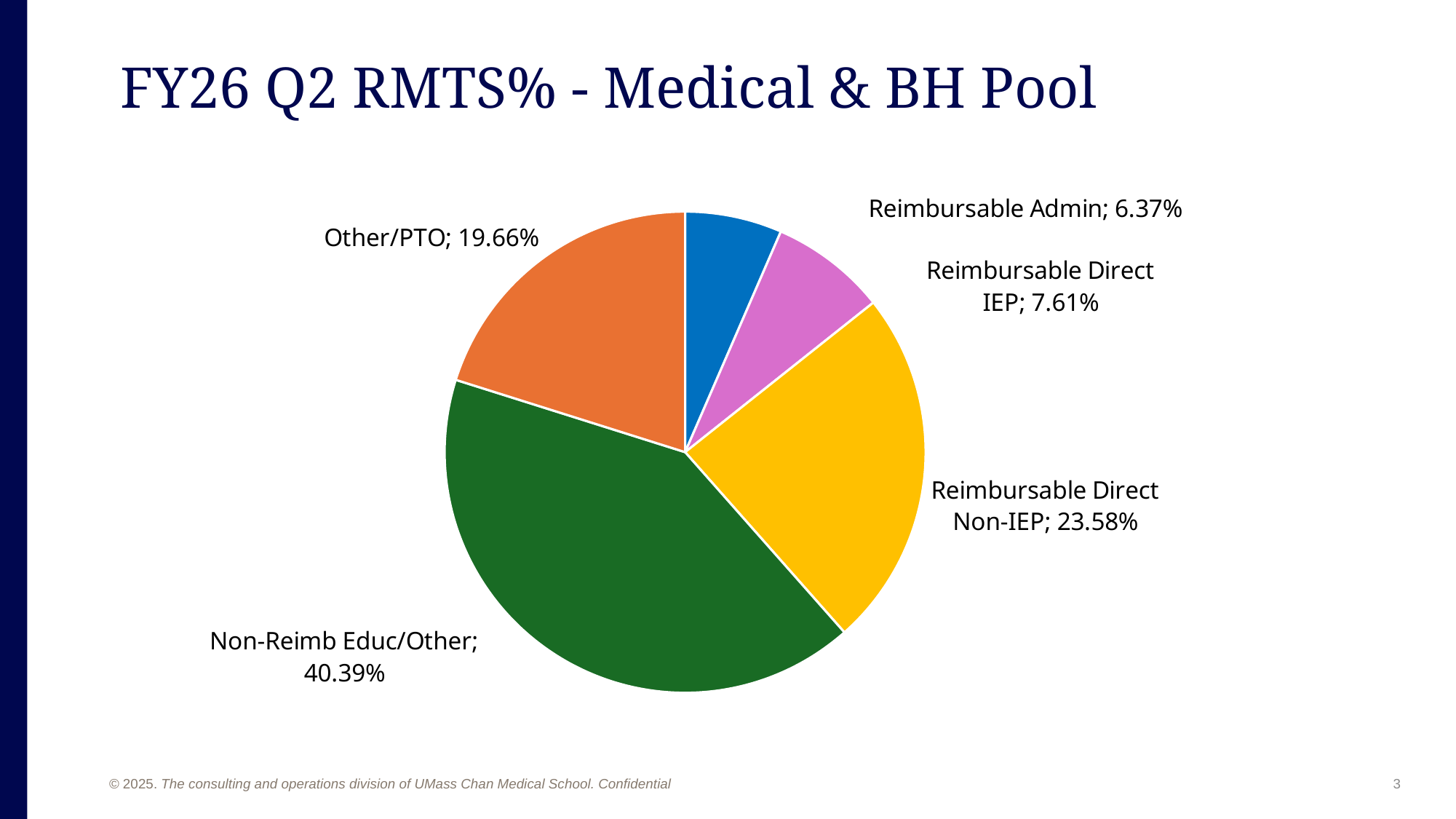
What percentage is shown for Reimbursable Admin? 6.37% How many slices does the pie chart have? 5 What is the title of the chart on the slide? FY26 Q2 RMTS% - Medical & BH Pool What percentage is shown for Reimbursable Direct Non-IEP? 23.58% What colour is the Non-Reimb Educ/Other slice? Green What is the difference between the Non-Reimb Educ/Other share and the Reimbursable Direct Non-IEP share? 16.81% What percentage is shown for Other/PTO? 19.66% What kind of chart is shown on the slide? Pie chart Which is larger, Reimbursable Direct IEP or Reimbursable Admin? Reimbursable Direct IEP Which category has the smallest share of the pie? Reimbursable Admin Which category has the largest share of the pie? Non-Reimb Educ/Other What percentage is shown for Non-Reimb Educ/Other? 40.39%